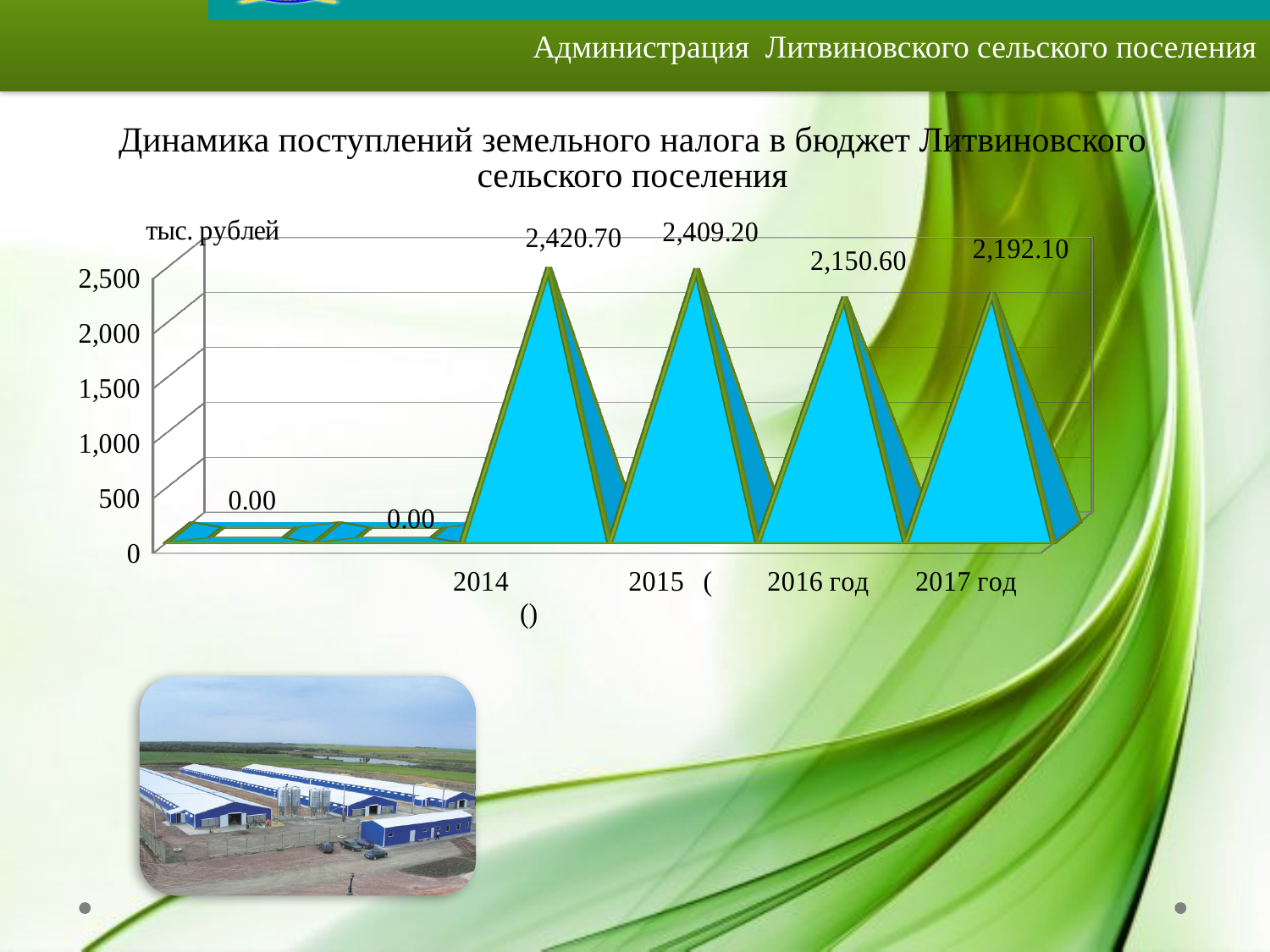
What is the value for 2017 год on the chart? 2,192.10 What unit is shown on the vertical axis of the chart? тыс. рублей What is the difference between the values for 2017 год and 2016 год? 41.50 Which year has the highest value on the chart? 2014 What kind of chart is shown on the slide? bar chart What is the difference between the values for 2014 and 2015? 11.50 What is the value for 2016 год on the chart? 2,150.60 What is the value for 2014 on the chart? 2,420.70 What is the value for 2015 on the chart? 2,409.20 Which is larger, the value for 2016 год or the value for 2017 год? 2017 год Among the years 2014 to 2017, which has the lowest value? 2016 год Is the value for 2016 год greater or less than 2,000? greater